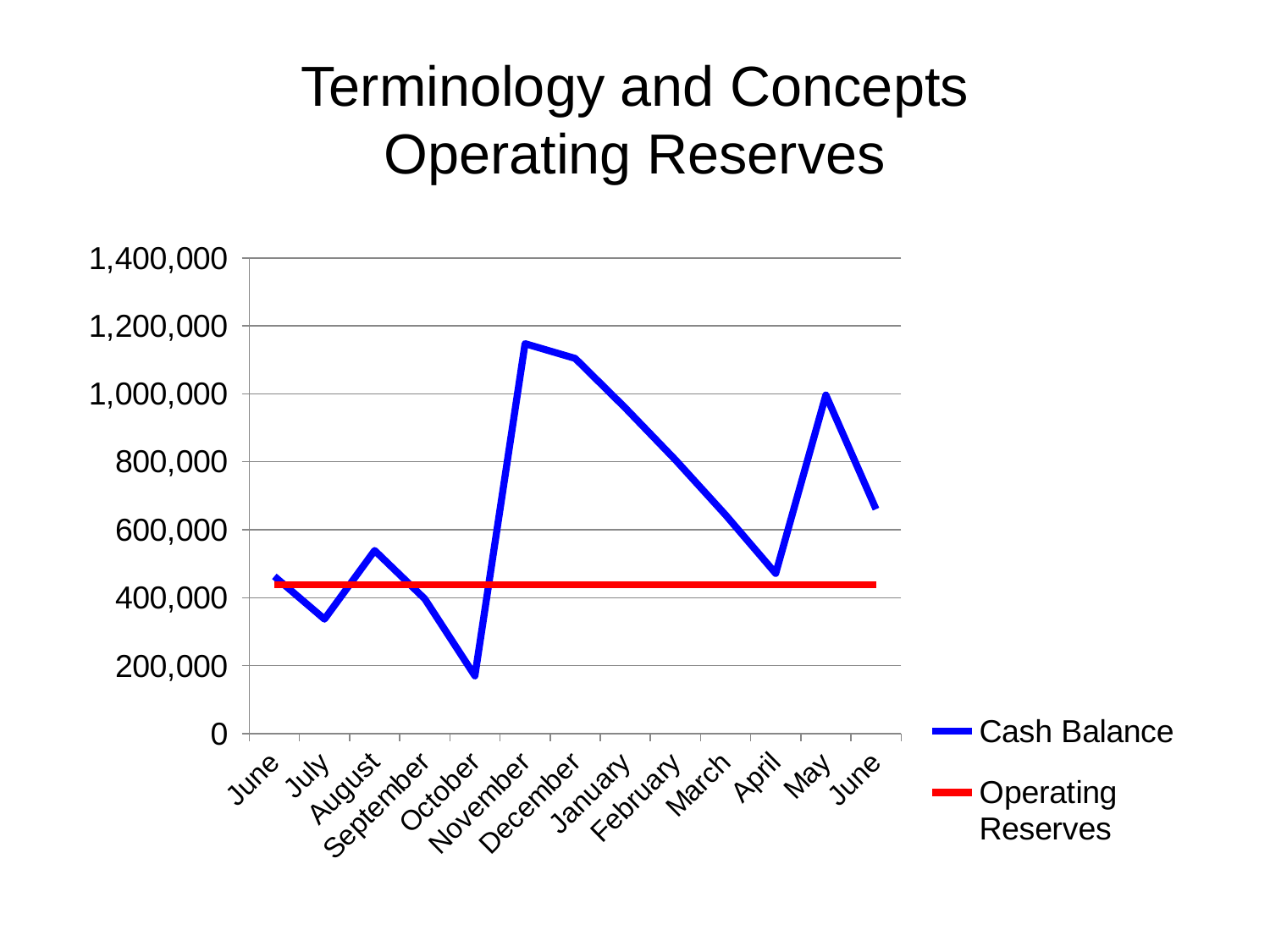
Is the Cash Balance for July greater or less than 400,000? less Is the Cash Balance for November greater or less than 1,000,000? greater In which month is the Cash Balance highest? November How many months are plotted along the x axis? 13 In which month is the Cash Balance lowest? October Is the Cash Balance for October greater or less than 200,000? less Does the Cash Balance rise or fall from November through April? Fall How many series does the legend list? 2 What kind of chart is shown on the slide? Line chart Which is larger, the Cash Balance in August or in July? August Which series is drawn in red? Operating Reserves